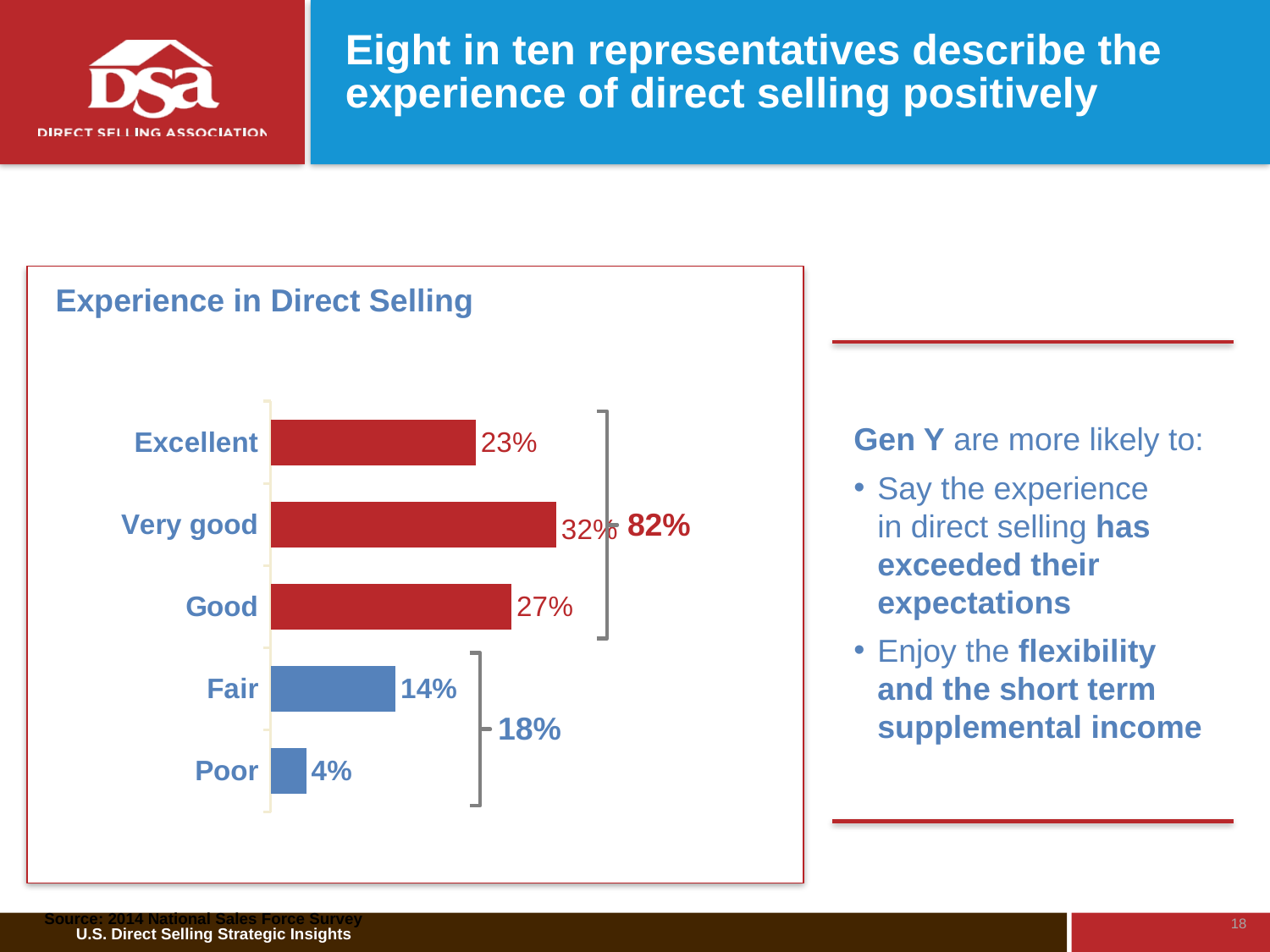
What is the title of the chart on the slide? Experience in Direct Selling What is the difference between the Good and Excellent values? 4% What is the difference between the Fair and Poor values? 10% Which category has the highest value in the Experience in Direct Selling chart? Very good What combined percentage is shown by the bracket grouping Excellent, Very good and Good? 82% What kind of chart is used to show Experience in Direct Selling? Bar chart What percentage of representatives rate their experience as Poor? 4% What is the value for Very good in the Experience in Direct Selling chart? 32% Which category has the lowest value in the Experience in Direct Selling chart? Poor What percentage of representatives rate their experience in direct selling as Excellent? 23% How many categories are shown in the Experience in Direct Selling chart? 5 Which is larger, the value for Good or the value for Fair? Good